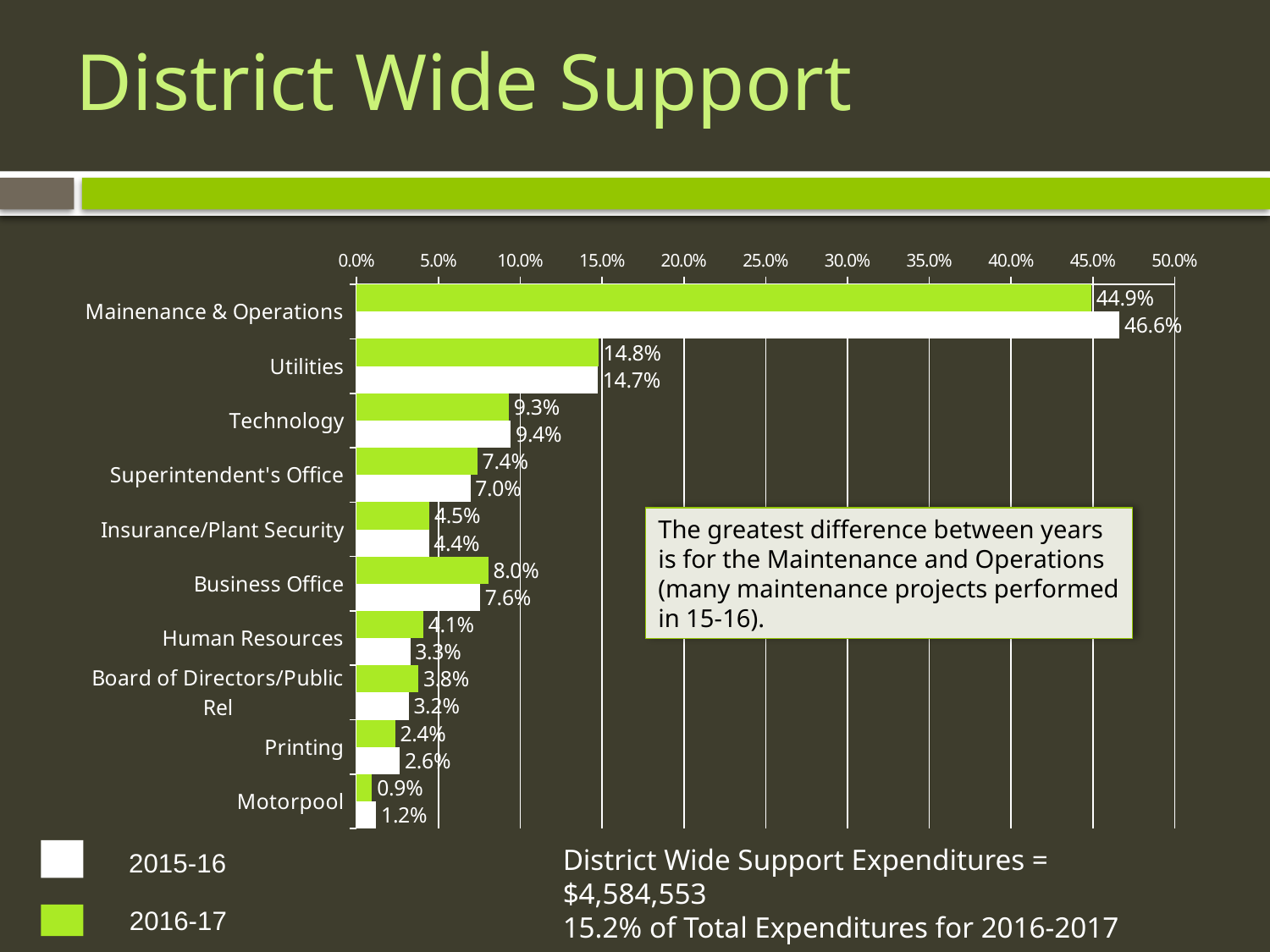
How many series does the legend list? 2 What is the 2015-16 value for Human Resources? 3.3% Which colour represents the 2016-17 series? Green What is the difference between the 2015-16 and 2016-17 values for Mainenance & Operations? 1.7% What is the 2015-16 value for Mainenance & Operations? 46.6% What is the difference between the 2016-17 values for Business Office and Human Resources? 3.9% What is the 2016-17 value for Utilities? 14.8% How many categories are shown on the chart? 10 Which is larger, the 2016-17 value for Business Office or the 2016-17 value for Superintendent's Office? Business Office Which category has the lowest 2015-16 value? Motorpool Which category has the highest 2016-17 value? Mainenance & Operations What kind of chart is shown on the slide? Bar chart